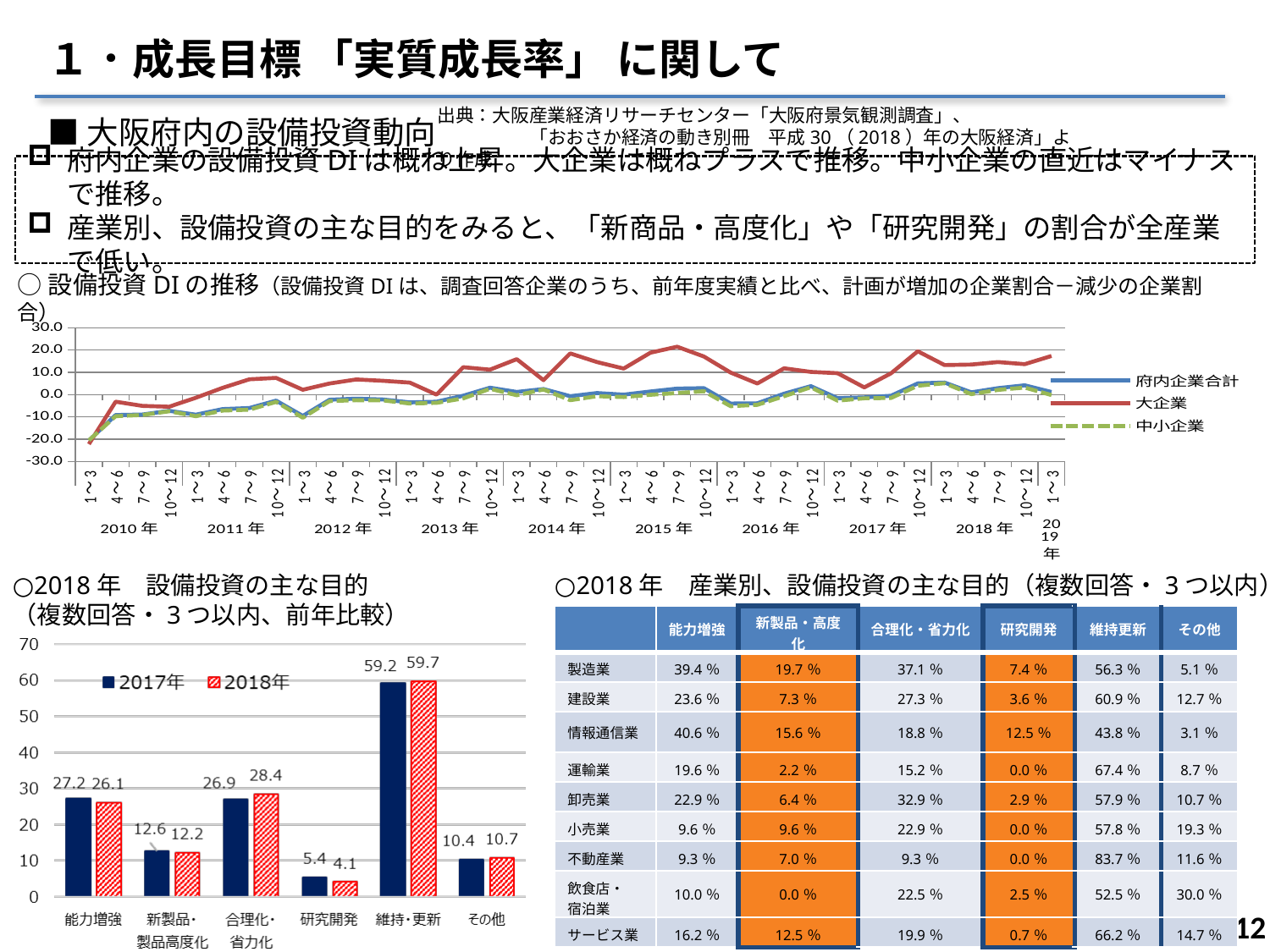
In the bar chart '2018年 設備投資の主な目的', which category has the highest 2018年 value? 維持・更新 In the bar chart '2018年 設備投資の主な目的', what is the 2017年 value for 能力増強? 27.2 In the bar chart '2018年 設備投資の主な目的', what is the difference between the 2018年 and 2017年 values for 合理化・省力化? 1.5 In the line chart '設備投資DIの推移', is the value for 大企業 at 2010年 1~3 greater or less than -10.0? less In the bar chart '2018年 設備投資の主な目的', how many categories are shown on the x axis? 6 In the bar chart '2018年 設備投資の主な目的', which is larger for 新製品・製品高度化: the 2017年 value or the 2018年 value? 2017年 In the bar chart '2018年 設備投資の主な目的', how many series does the legend list? 2 In the line chart '設備投資DIの推移', how many series does the legend list? 3 In the bar chart '2018年 設備投資の主な目的', what is the 2018年 value for 維持・更新? 59.7 What kind of chart is the '設備投資DIの推移' chart at the top of the slide? line chart In the bar chart '2018年 設備投資の主な目的', which category has the lowest 2017年 value? 研究開発 In the bar chart '2018年 設備投資の主な目的', what is the 2018年 value for 研究開発? 4.1